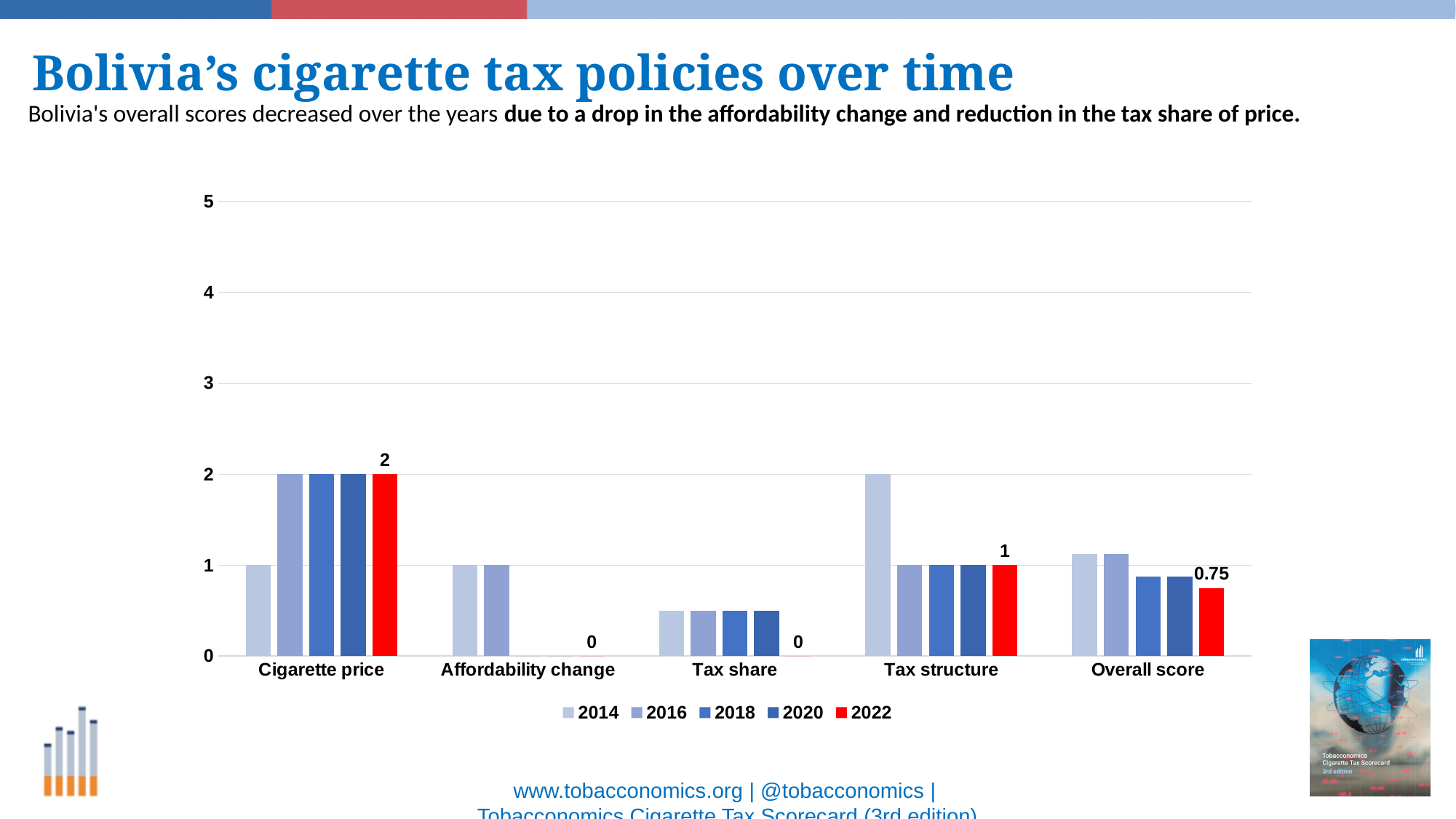
Is the value for Overall score in 2014 greater or less than 1? greater Which category has the highest value for 2022? Cigarette price What kind of chart is shown on the slide? Bar chart Does the Overall score rise or fall from 2014 to 2022? Fall What is the value for Cigarette price in 2022? 2 What is the value for Tax structure in 2022? 1 How many series does the legend list? 5 How many categories are shown on the x axis? 5 What is the difference between the 2022 values for Cigarette price and Tax structure? 1 What is the value for Overall score in 2022? 0.75 Which is larger in 2022: Cigarette price or Tax structure? Cigarette price What is the value for Affordability change in 2022? 0